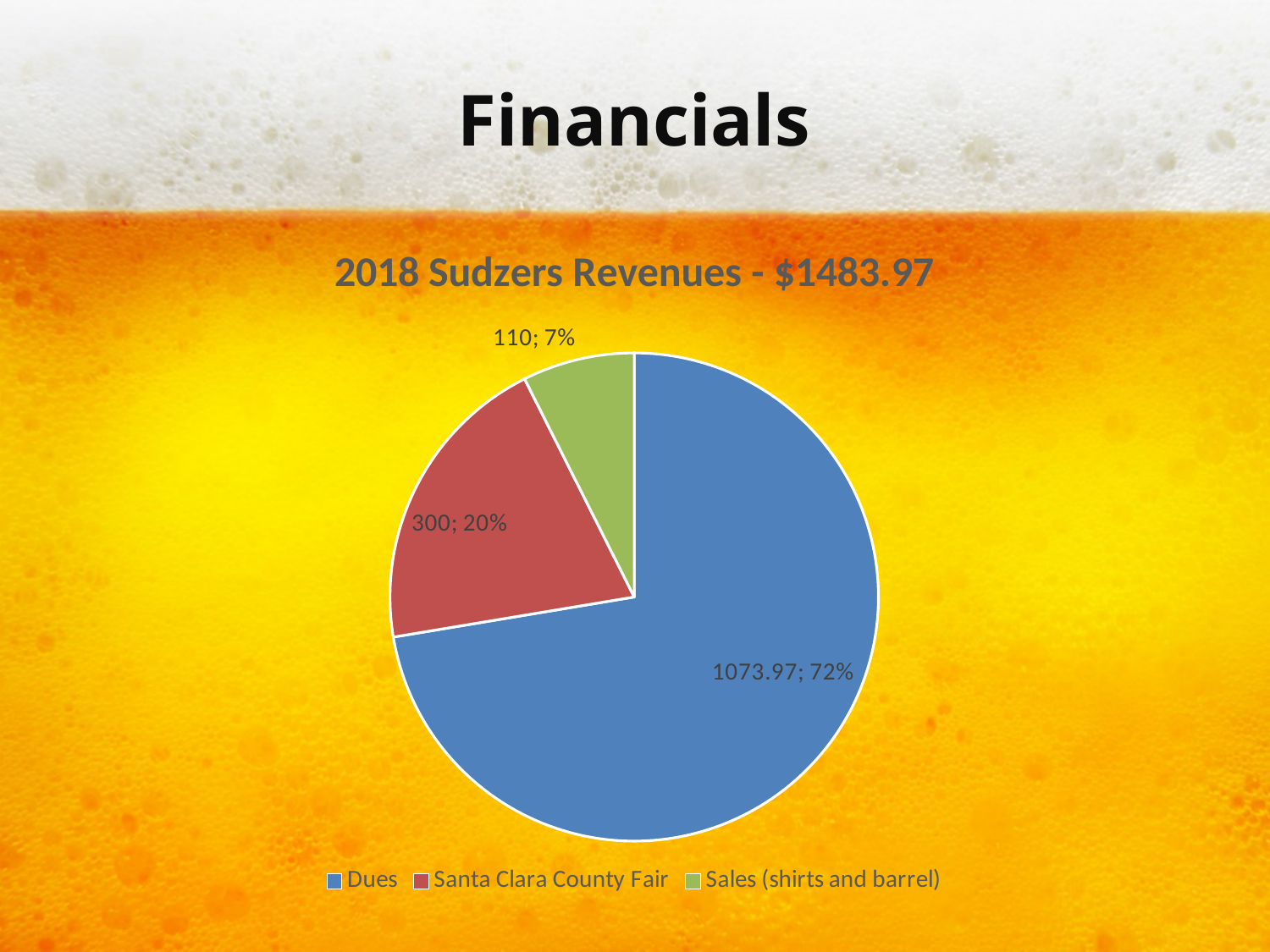
What share of the pie does Sales (shirts and barrel) represent? 7% What is the difference between the values for Santa Clara County Fair and Sales (shirts and barrel)? 190 What is the value for Sales (shirts and barrel)? 110 What is the value for Santa Clara County Fair? 300 What is the title of the chart? 2018 Sudzers Revenues - $1483.97 What share of the pie does Dues represent? 72% Which category has the largest slice? Dues What type of chart is shown on the slide? pie chart Which category has the smallest slice? Sales (shirts and barrel) What is the value for Dues? 1073.97 What share of the pie does Santa Clara County Fair represent? 20% How many categories does the legend list? 3